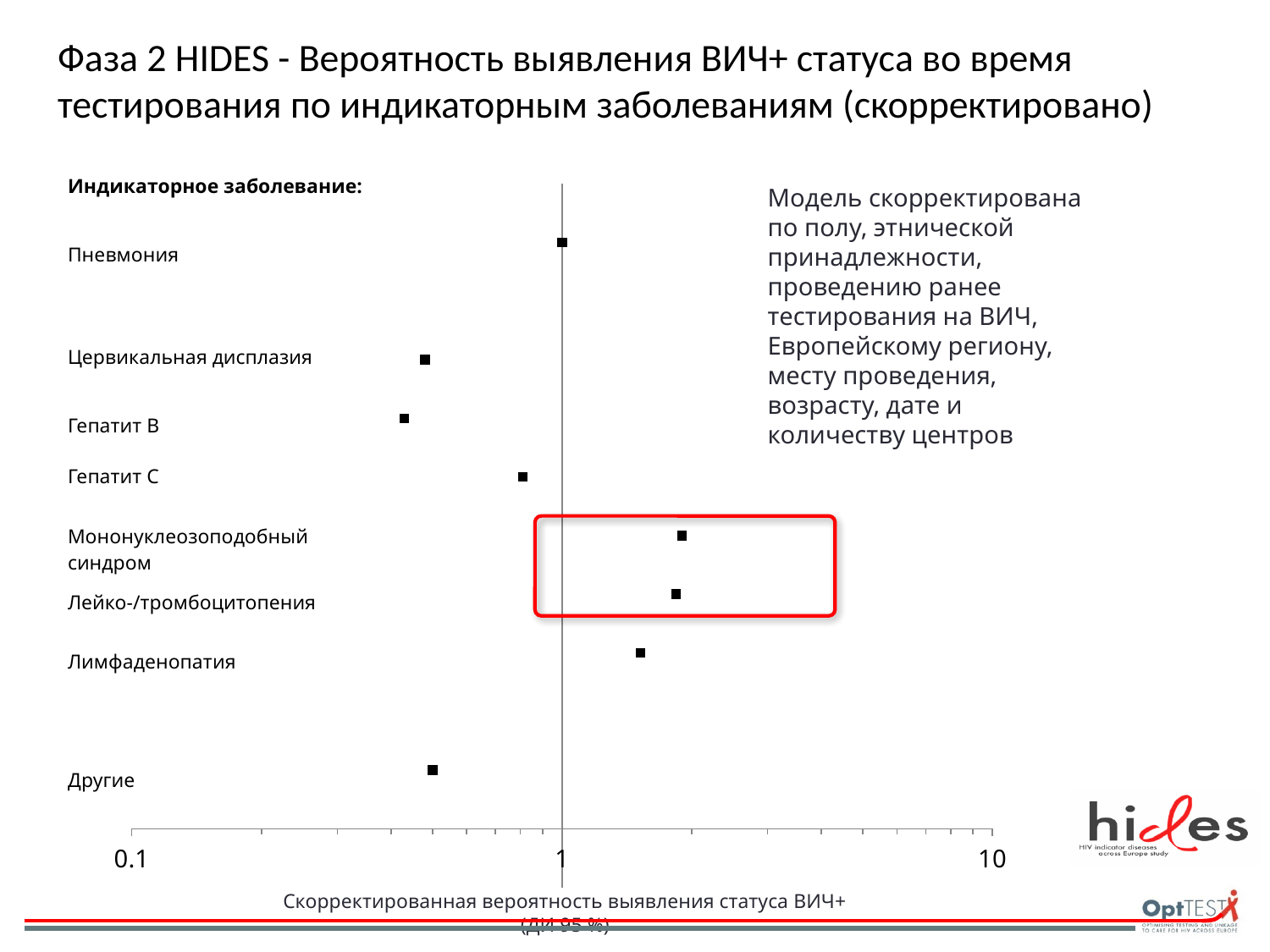
Is the value for Мононуклеозоподобный синдром greater or less than 1? greater How many indicator diseases are plotted on the chart? 8 What are the tick values shown on the x axis? 0.1, 1, 10 Which indicator disease has the lowest adjusted probability on the chart? Гепатит B Which has the larger value, Гепатит B or Гепатит C? Гепатит C Is the value for Лейко-/тромбоцитопения greater or less than 1? greater Is the value for Лимфаденопатия greater or less than 1? greater Which has the larger value, Лимфаденопатия or Другие? Лимфаденопатия What kind of chart is shown on the slide? Scatter (dot) plot